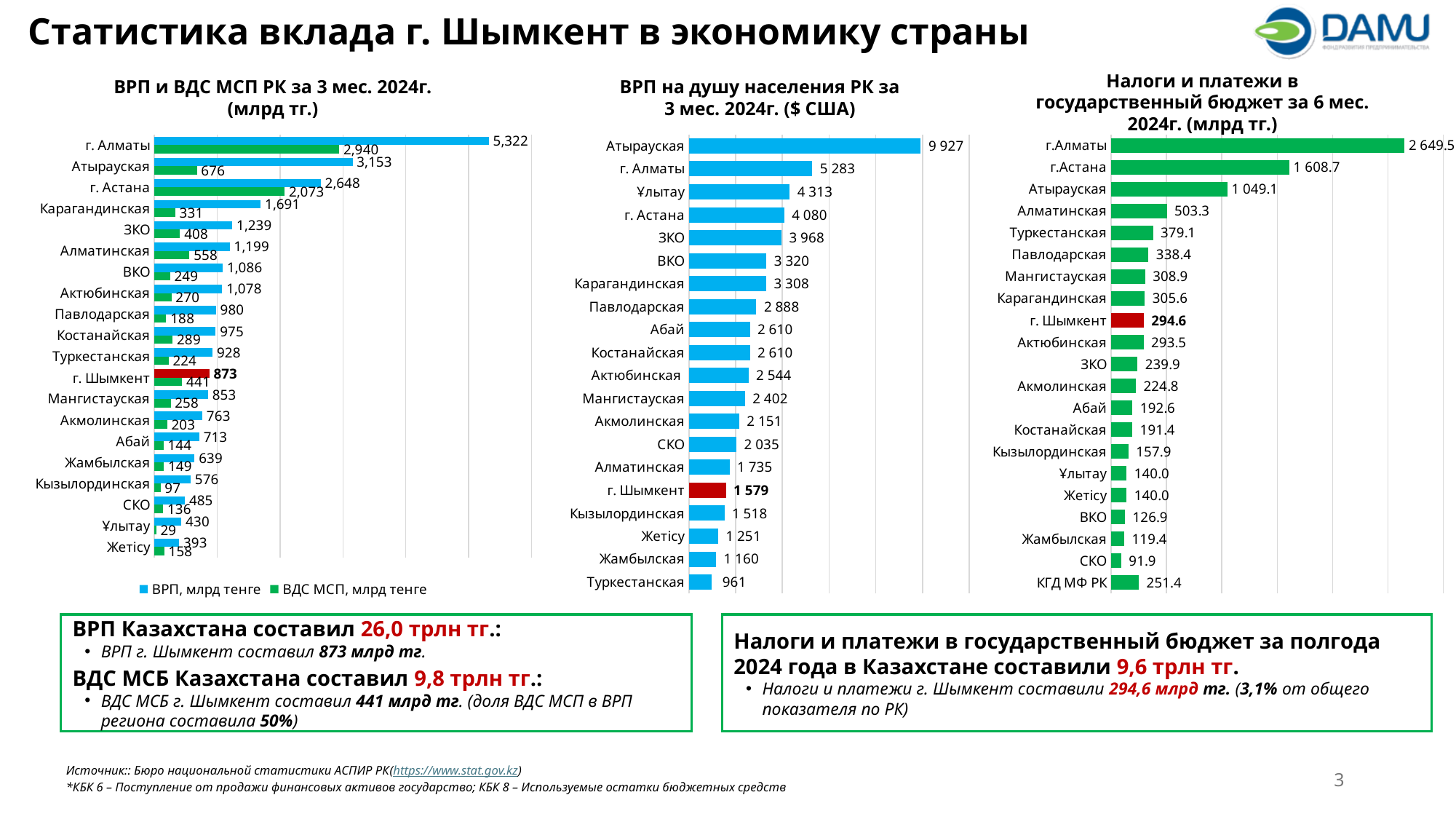
What type of chart is the chart 'Налоги и платежи в государственный бюджет за 6 мес. 2024г.'? Bar chart In the chart 'ВРП на душу населения РК за 3 мес. 2024г.', what is the value for г. Шымкент? 1 579 In the chart 'ВРП и ВДС МСП РК за 3 мес. 2024г.', what is the difference between the ВРП and ВДС МСП values for г. Алматы? 2,382 In the chart 'ВРП и ВДС МСП РК за 3 мес. 2024г.', what is the ВДС МСП value for г. Астана? 2,073 In the chart 'ВРП на душу населения РК за 3 мес. 2024г.', which region has the lowest value? Туркестанская In the chart 'ВРП на душу населения РК за 3 мес. 2024г.', how many regions are shown? 20 In the chart 'ВРП и ВДС МСП РК за 3 мес. 2024г.', which region has the highest ВРП value? г. Алматы In the chart 'ВРП и ВДС МСП РК за 3 мес. 2024г.', how many series does the legend list? 2 In the chart 'ВРП и ВДС МСП РК за 3 мес. 2024г.', what is the ВРП value for г. Шымкент? 873 In the chart 'Налоги и платежи в государственный бюджет за 6 мес. 2024г.', what is the value for г. Шымкент? 294.6 In the chart 'ВРП на душу населения РК за 3 мес. 2024г.', which is larger: the value for Ұлытау or the value for г. Астана? Ұлытау In the chart 'Налоги и платежи в государственный бюджет за 6 мес. 2024г.', what is the difference between the values for г.Алматы and г.Астана? 1 040.8